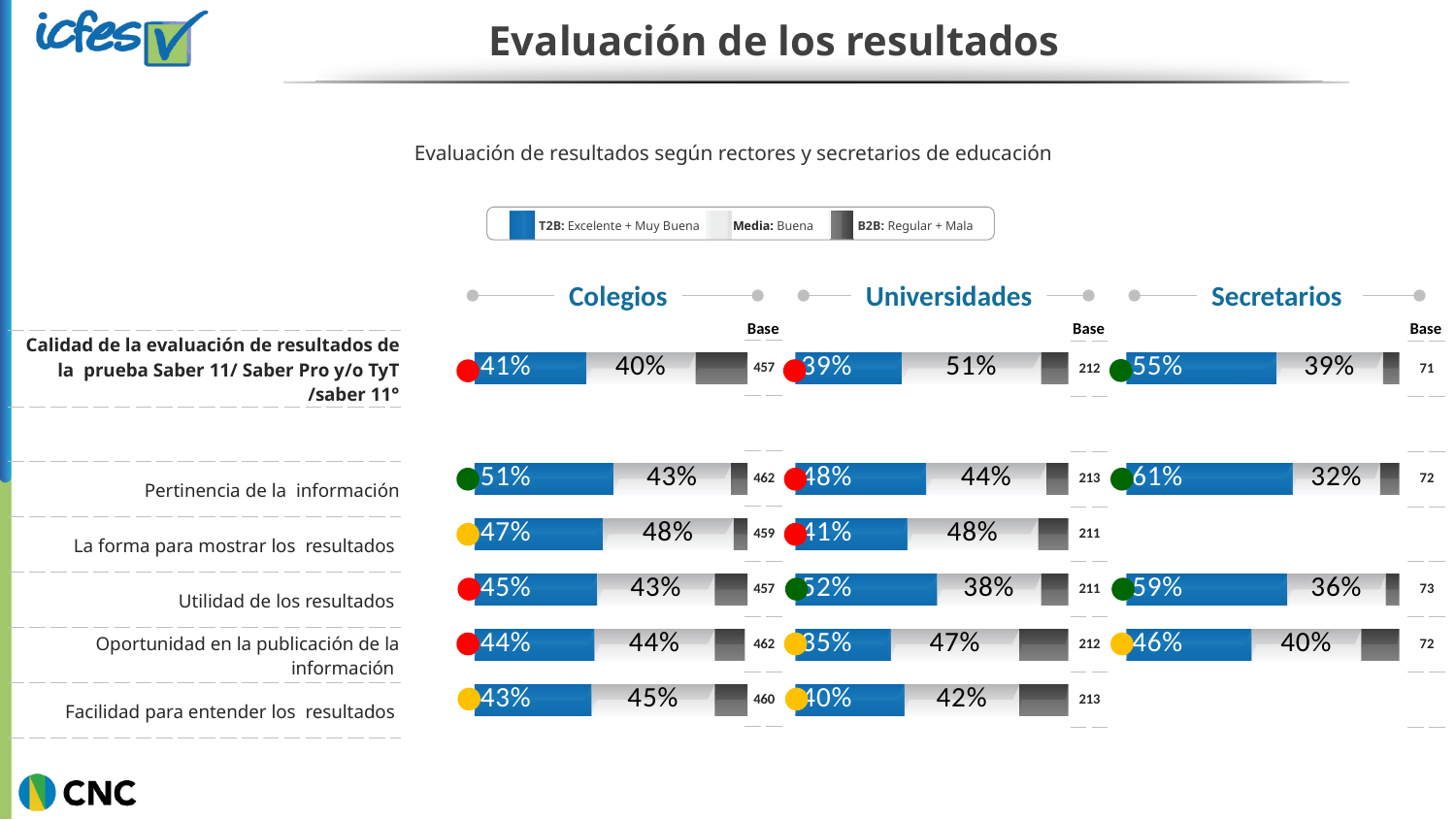
What kind of chart is used to show the evaluation results? Stacked bar chart In the Universidades chart, which item has the lowest T2B value? Oportunidad en la publicación de la información How many items have bars in the Secretarios chart? 4 For 'Utilidad de los resultados', which chart shows the larger T2B value, Colegios or Universidades? Universidades In the Universidades chart, what is the Media value for 'Calidad de la evaluación de resultados de la prueba Saber 11/ Saber Pro y/o TyT /saber 11°'? 51% In the Secretarios chart, what is the Media value for 'Utilidad de los resultados'? 36% In the Secretarios chart, what is the difference between the T2B value for 'Pertinencia de la información' and the T2B value for 'Oportunidad en la publicación de la información'? 15 percentage points In the Colegios chart, what is the T2B value for 'Pertinencia de la información'? 51% According to the legend, what does T2B stand for? Excelente + Muy Buena In the Secretarios chart, which item has the highest T2B value? Pertinencia de la información In the Colegios chart, what is the Base for 'Facilidad para entender los resultados'? 460 How many series does the legend list? 3